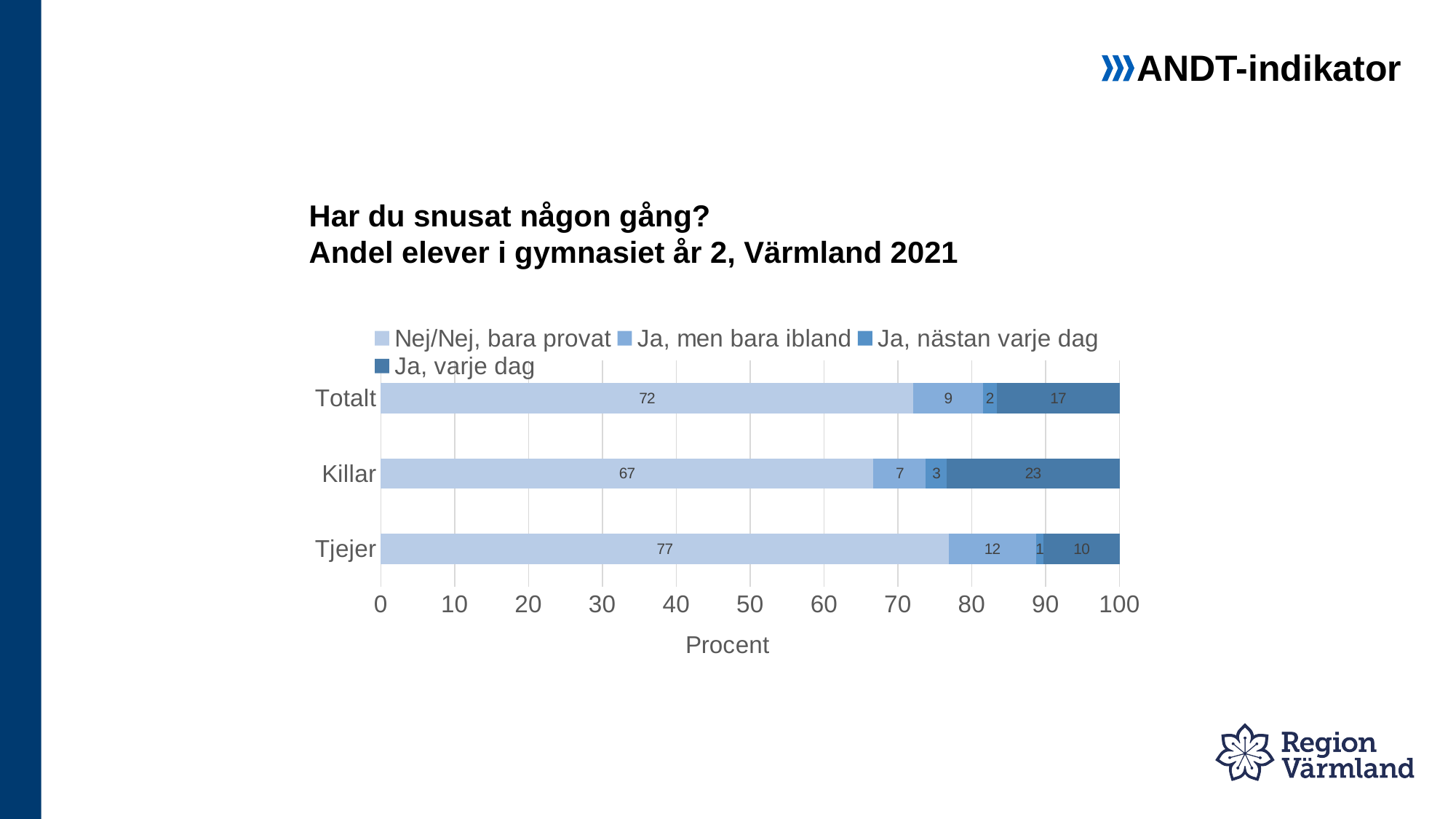
Which is larger: the "Ja, men bara ibland" value for Tjejer or for Killar? Tjejer What kind of chart is shown on the slide? Stacked bar chart What is the value of "Nej/Nej, bara provat" for Killar? 67 What is the difference between the "Ja, varje dag" values for Killar and Tjejer? 13 How many series does the legend list? 4 Which category has the highest value for "Ja, varje dag"? Killar How many categories are shown on the vertical axis? 3 What is the total of the stacked bar for Totalt? 100 What is the label of the horizontal axis? Procent What is the value of "Ja, men bara ibland" for Totalt? 9 What is the value of "Ja, varje dag" for Tjejer? 10 Which category has the lowest value for "Nej/Nej, bara provat"? Killar